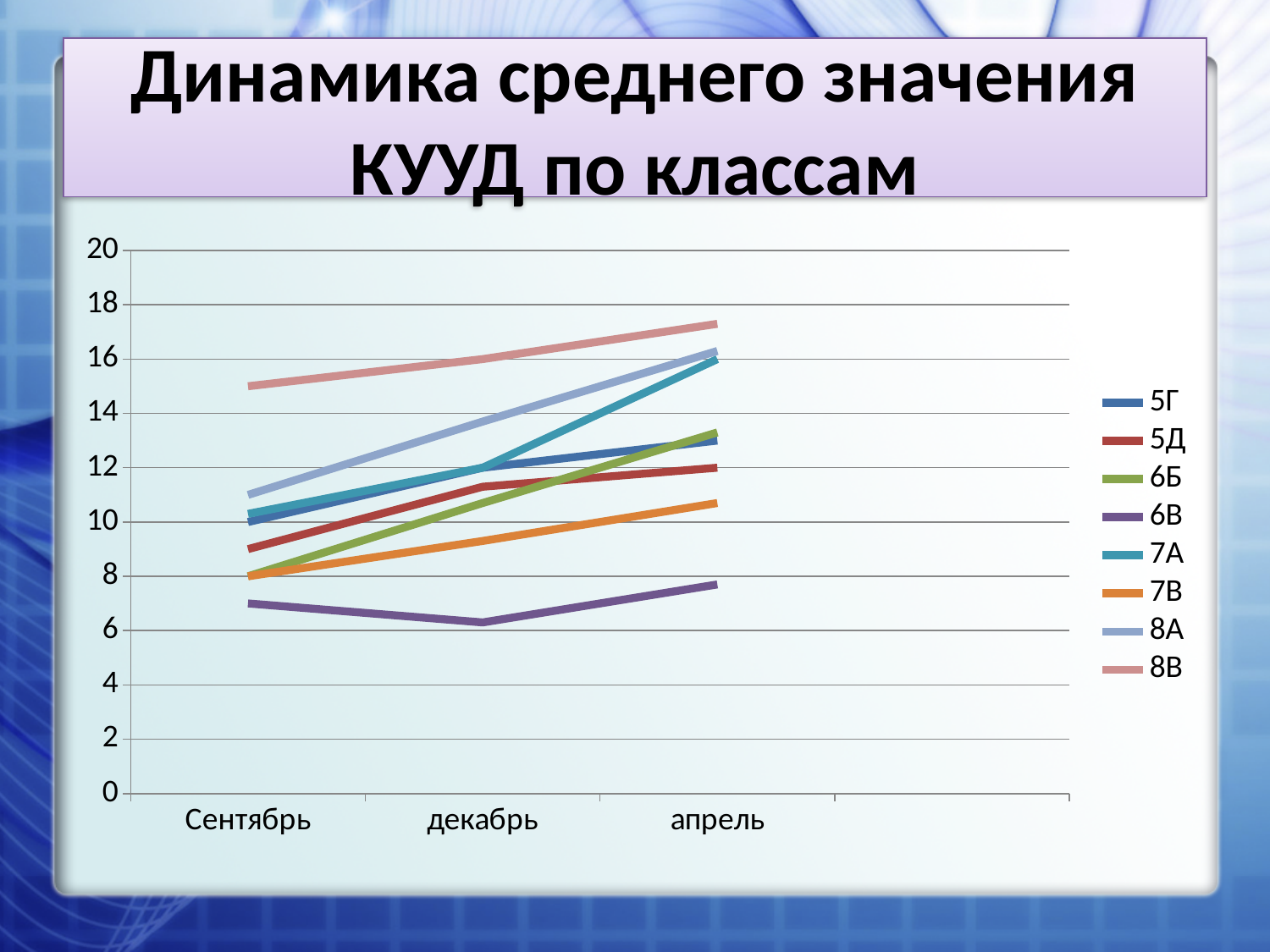
Which class has the lowest value in апрель? 6В How many series does the legend list? 8 What is the title of the chart? Динамика среднего значения КУУД по классам What kind of chart is shown on the slide? line chart How many time points are shown along the x axis? 3 Which class is listed first in the legend? 5Г Is the value for 6В in декабрь greater or less than 8? less Is the value for 8В in Сентябрь greater or less than 14? greater Which is larger in апрель: the value for 8В or the value for 6В? 8В Do the values for 8В rise or fall from Сентябрь to апрель? rise Which class has the highest value in Сентябрь? 8В Is the value for 8В in апрель greater or less than 16? greater